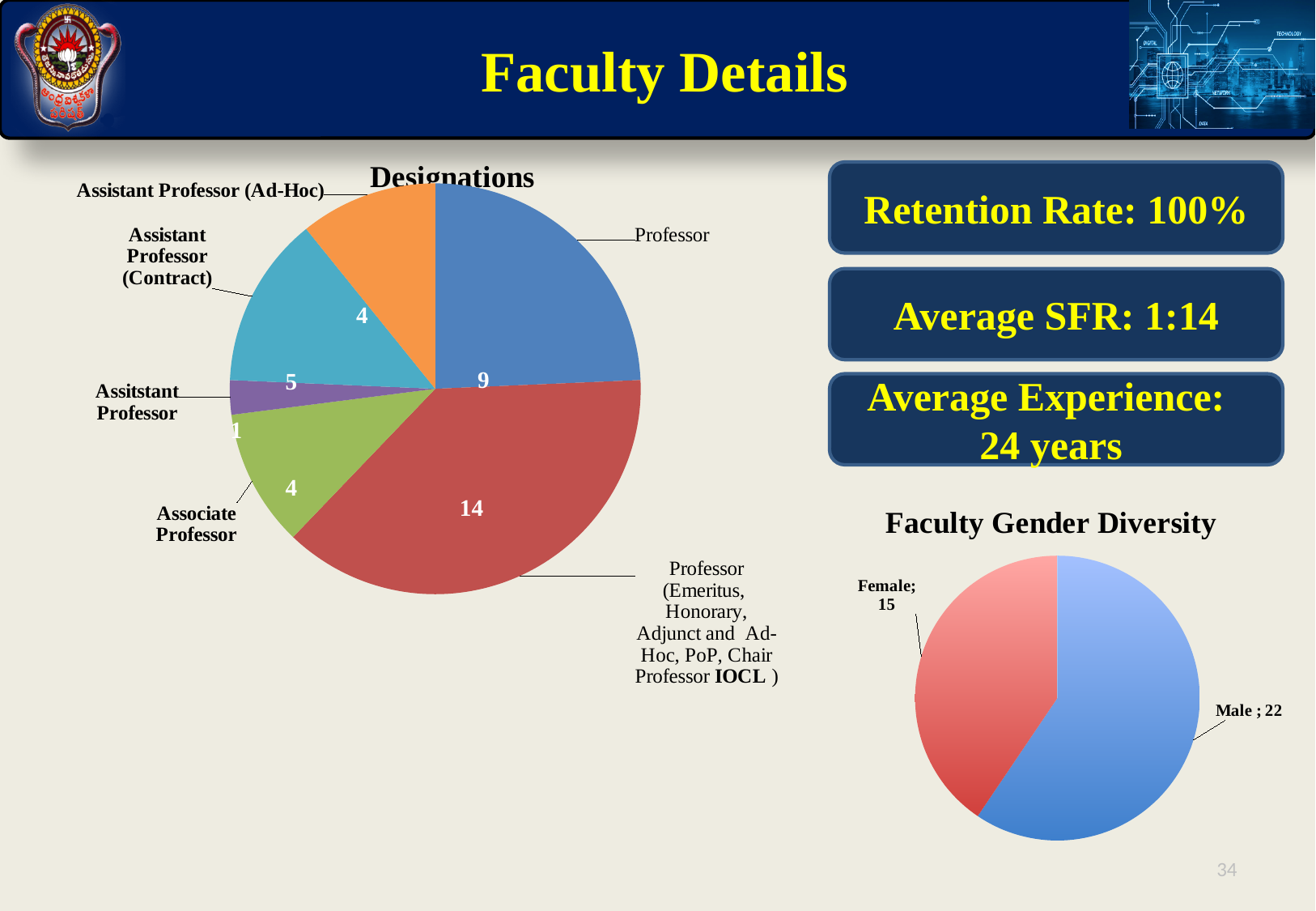
In the Designations pie chart, what is the value for Assistant Professor (Contract)? 5 What type of chart is the Faculty Gender Diversity chart? Pie chart In the Designations pie chart, how many faculty are Professors? 9 How many designation categories are shown in the Designations pie chart? 6 In the Faculty Gender Diversity chart, what colour is the Male slice? Blue In the Designations pie chart, which designation has the largest slice? Professor (Emeritus, Honorary, Adjunct and Ad-Hoc, PoP, Chair Professor IOCL) In the Designations pie chart, which designation has the smallest slice? Assistant Professor In the Designations pie chart, what is the value for Associate Professor? 4 In the Faculty Gender Diversity chart, how many faculty are Female? 15 In the Faculty Gender Diversity chart, what is the difference between Male and Female counts? 7 In the Designations pie chart, what is the difference between the Professor (Emeritus, Honorary, Adjunct and Ad-Hoc, PoP, Chair Professor IOCL) value and the Professor value? 5 In the Designations pie chart, which is larger: Assistant Professor (Contract) or Assistant Professor (Ad-Hoc)? Assistant Professor (Contract)